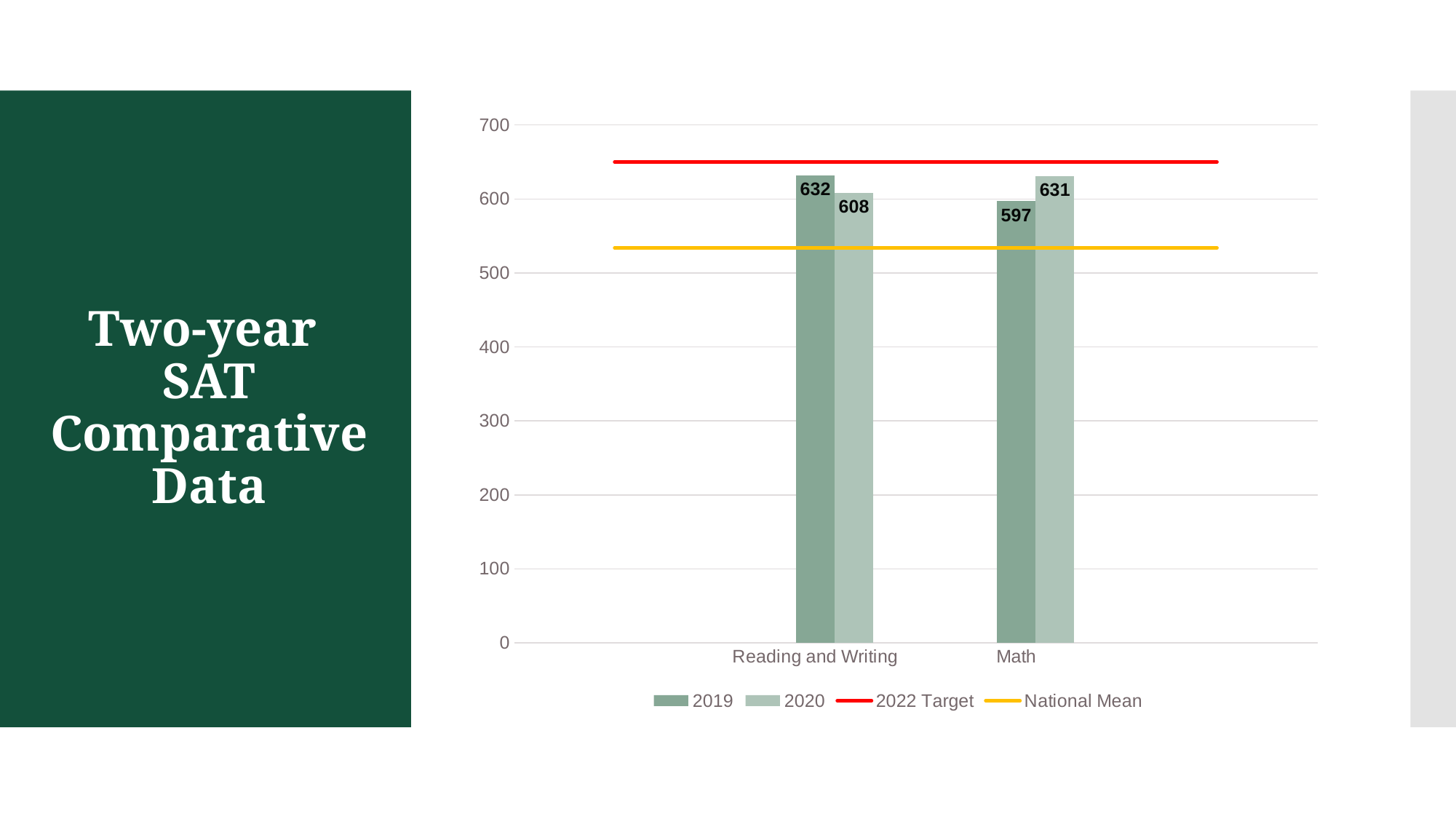
What is the difference between the 2019 and 2020 values for Reading and Writing? 24 What is the 2019 value for Math? 597 Is the National Mean line greater or less than 600? less Which category has the highest 2020 value? Math By how much did the Math value increase from 2019 to 2020? 34 Is the 2022 Target line greater or less than 600? greater What is the 2019 value for Reading and Writing? 632 What is the 2020 value for Reading and Writing? 608 Which category has the higher 2019 value, Reading and Writing or Math? Reading and Writing How many series does the legend list? 4 What kind of chart is shown on the slide? combination bar and line chart What is the 2020 value for Math? 631